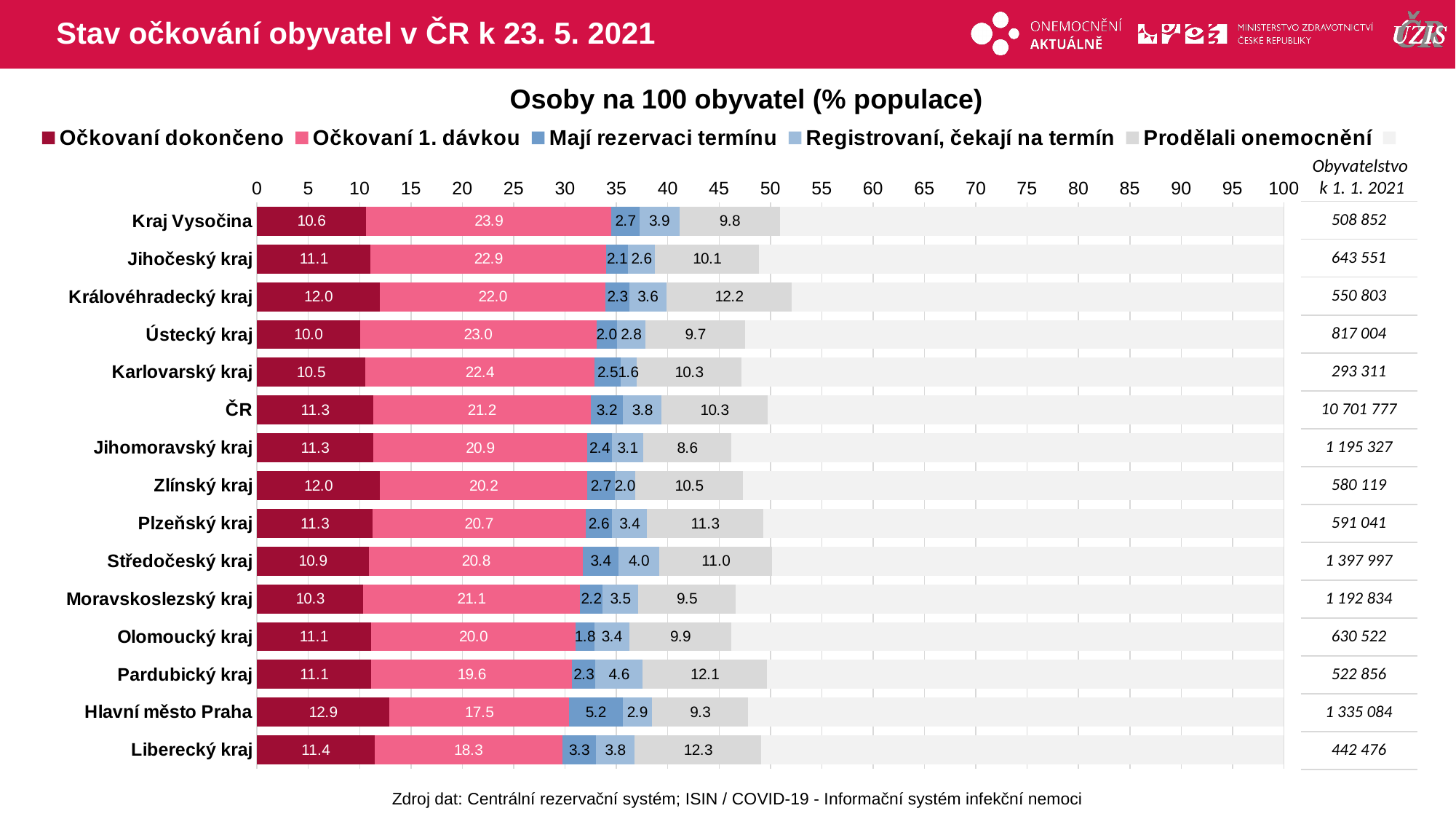
How many regions (categories) are plotted on the chart? 15 What is the 'Očkovaní dokončeno' value for Hlavní město Praha? 12.9 What is the 'Prodělali onemocnění' value for Královéhradecký kraj? 12.2 Which region has the lowest 'Prodělali onemocnění' value? Jihomoravský kraj Which has the larger 'Mají rezervaci termínu' value, Hlavní město Praha or ČR? Hlavní město Praha What is the 'Očkovaní 1. dávkou' value for ČR? 21.2 Which region has the highest 'Očkovaní dokončeno' value? Hlavní město Praha What kind of chart is shown on the slide? Stacked bar chart Which region has the lowest 'Očkovaní dokončeno' value? Ústecký kraj What is the difference between the 'Očkovaní dokončeno' values of Hlavní město Praha and Ústecký kraj? 2.9 What is the 'Registrovaní, čekají na termín' value for Pardubický kraj? 4.6 What is the total of the five labelled segments for Kraj Vysočina? 50.9